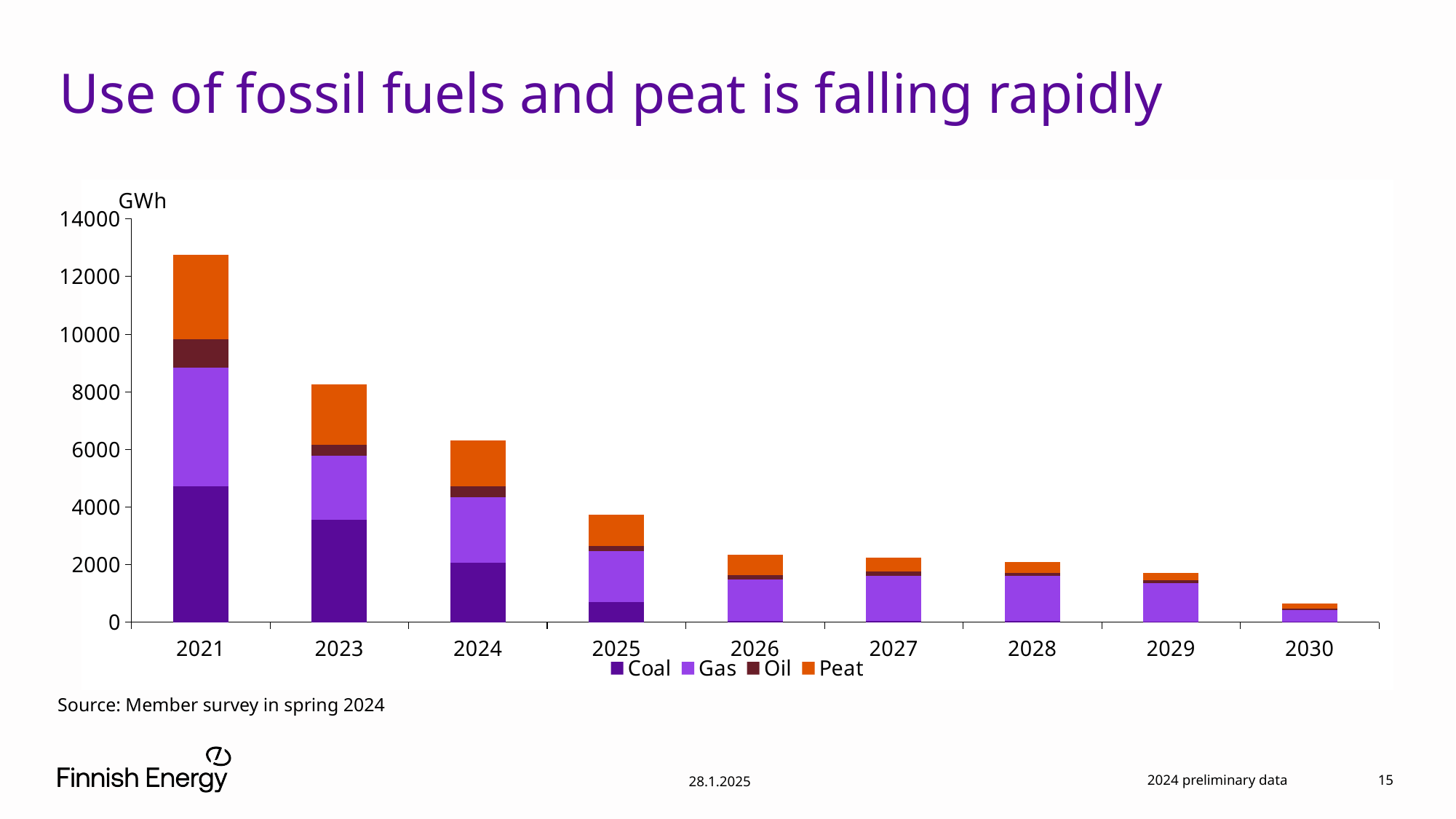
Is the total bar for 2030 greater or less than 2000 GWh? less How many series does the chart's legend list? 4 Which year has the larger total bar, 2023 or 2024? 2023 Do the total bar heights rise or fall from 2021 to 2030? Fall What kind of chart is shown on the slide? Stacked bar chart What is the title of the slide containing the chart? Use of fossil fuels and peat is falling rapidly How many years are shown on the x axis of the chart? 9 Is the total bar for 2021 greater or less than 12000 GWh? greater Which year has the lowest total bar in the chart? 2030 Is the total bar for 2025 greater or less than 4000 GWh? less What unit is shown on the y axis of the chart? GWh Which year has the highest total bar in the chart? 2021